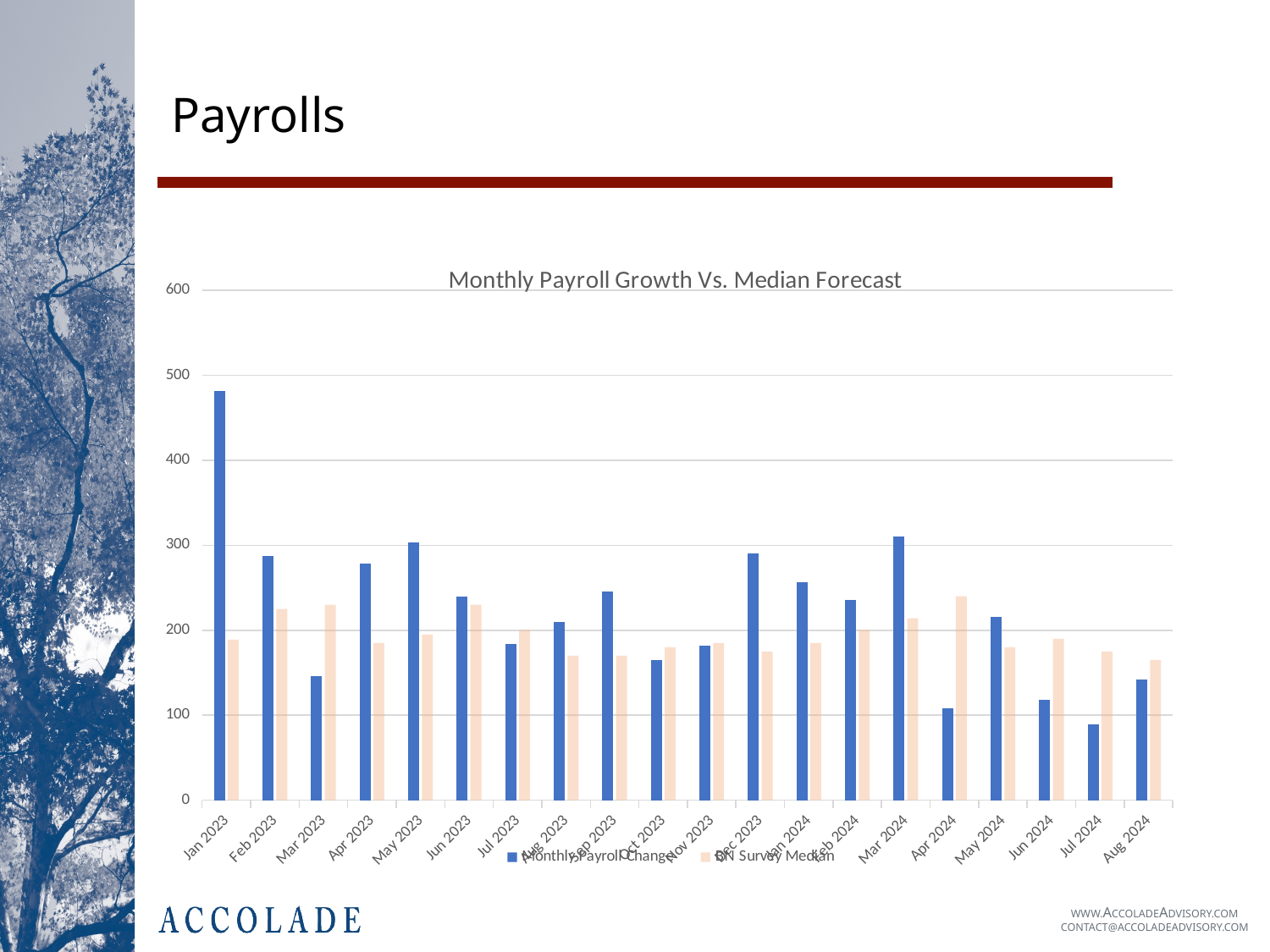
Is the Monthly Payroll Change value for Jan 2023 greater or less than 400? greater Which month has the highest Monthly Payroll Change value? Jan 2023 What is the title of the chart? Monthly Payroll Growth Vs. Median Forecast Do the Monthly Payroll Change values rise or fall from Jan 2023 to Mar 2023? Fall Is the BN Survey Median value for Apr 2024 greater or less than 200? greater In Apr 2024, which is larger: the Monthly Payroll Change or the BN Survey Median? BN Survey Median Is the Monthly Payroll Change value for Mar 2023 greater or less than 200? less Which month has the lowest Monthly Payroll Change value? Jul 2024 What kind of chart is shown on the slide? Bar chart How many series does the chart's legend list? 2 How many months are shown on the x axis of the chart? 20